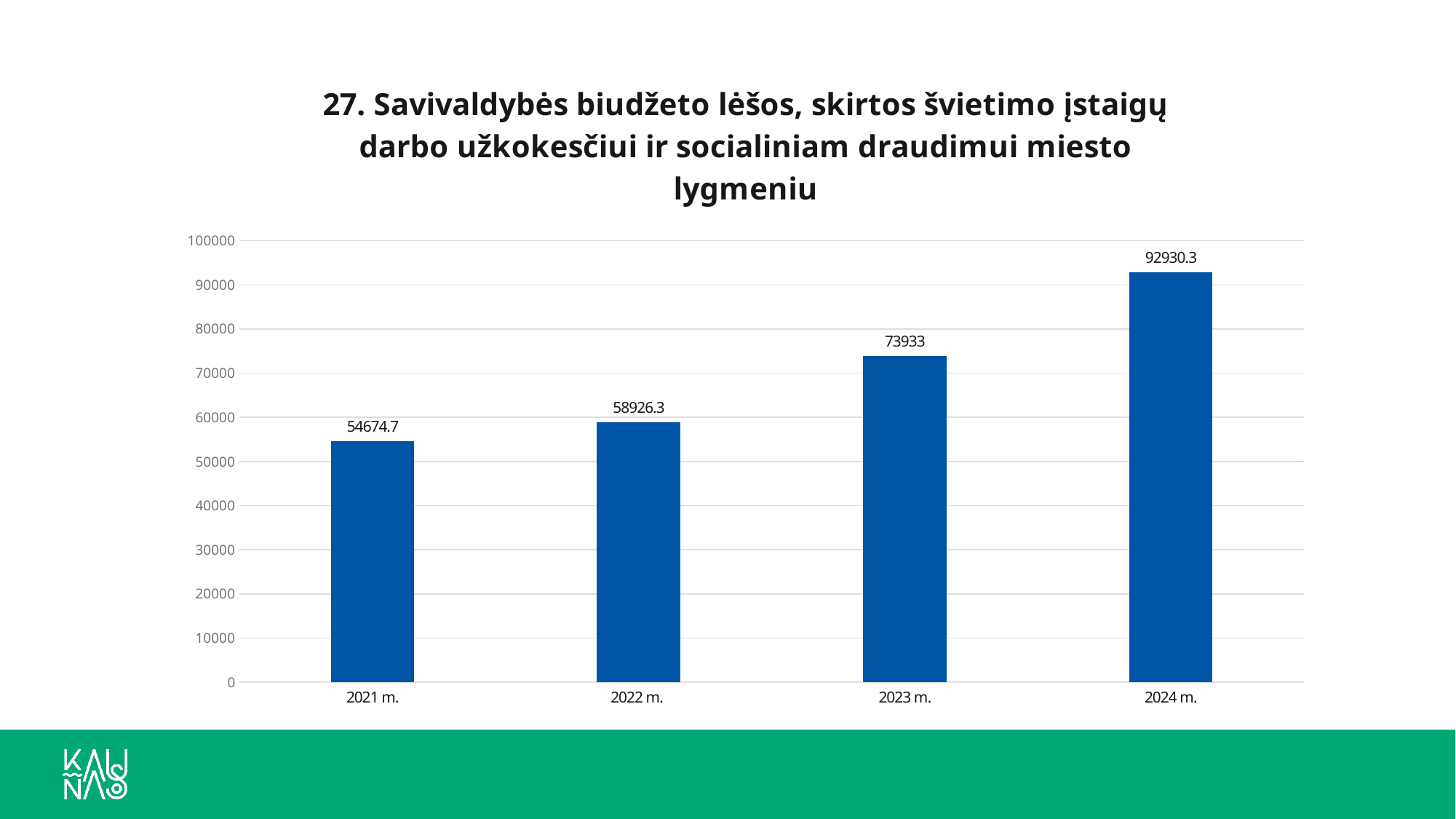
What is the value for 2023 m.? 73933 What is the value for 2021 m.? 54674.7 Which is larger, the value for 2023 m. or the value for 2022 m.? 2023 m. What is the difference between the values for 2022 m. and 2021 m.? 4251.6 Which year has the lowest value? 2021 m. What kind of chart is shown on the slide? bar chart Is the value for 2024 m. greater or less than 90000? greater Which year has the highest value? 2024 m. What is the difference between the values for 2024 m. and 2023 m.? 18997.3 How many years are shown on the x axis? 4 What is the value for 2022 m.? 58926.3 What is the value for 2024 m.? 92930.3